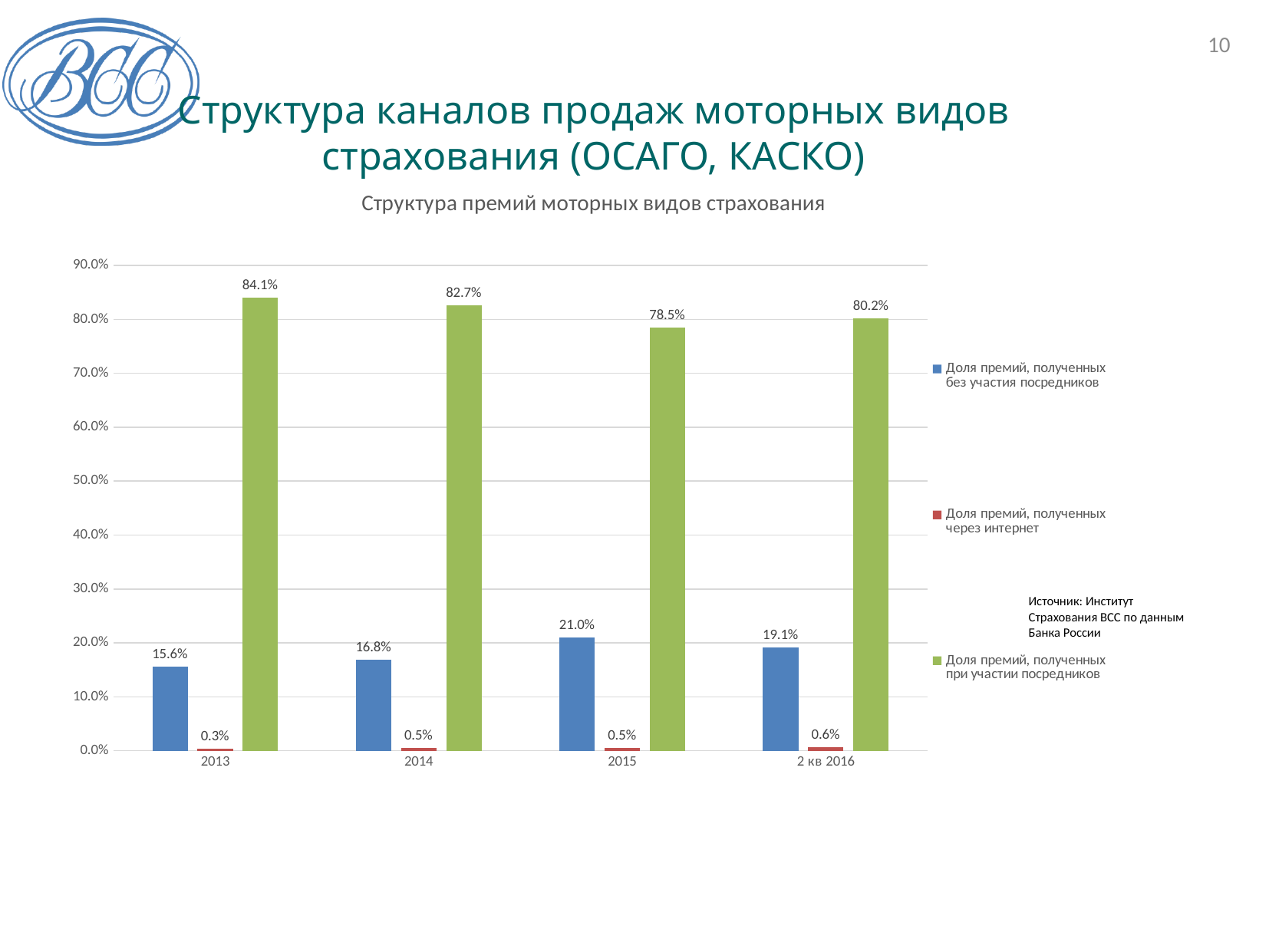
How many periods are shown on the x axis? 4 What is the difference between 'Доля премий, полученных при участии посредников' in 2013 and in 2 кв 2016? 3.9% What kind of chart is shown? Bar chart In which period is 'Доля премий, полученных без участия посредников' highest? 2015 Does 'Доля премий, полученных через интернет' rise or fall from 2013 to 2015? Rise What is the value for 'Доля премий, полученных через интернет' in 2 кв 2016? 0.6% Which is larger: 'Доля премий, полученных без участия посредников' in 2014 or in 2 кв 2016? 2 кв 2016 In which period is 'Доля премий, полученных при участии посредников' lowest? 2015 How many series does the legend list? 3 What is the title of the chart? Структура премий моторных видов страхования What is the value for 'Доля премий, полученных без участия посредников' in 2015? 21.0% What is the value for 'Доля премий, полученных при участии посредников' in 2013? 84.1%